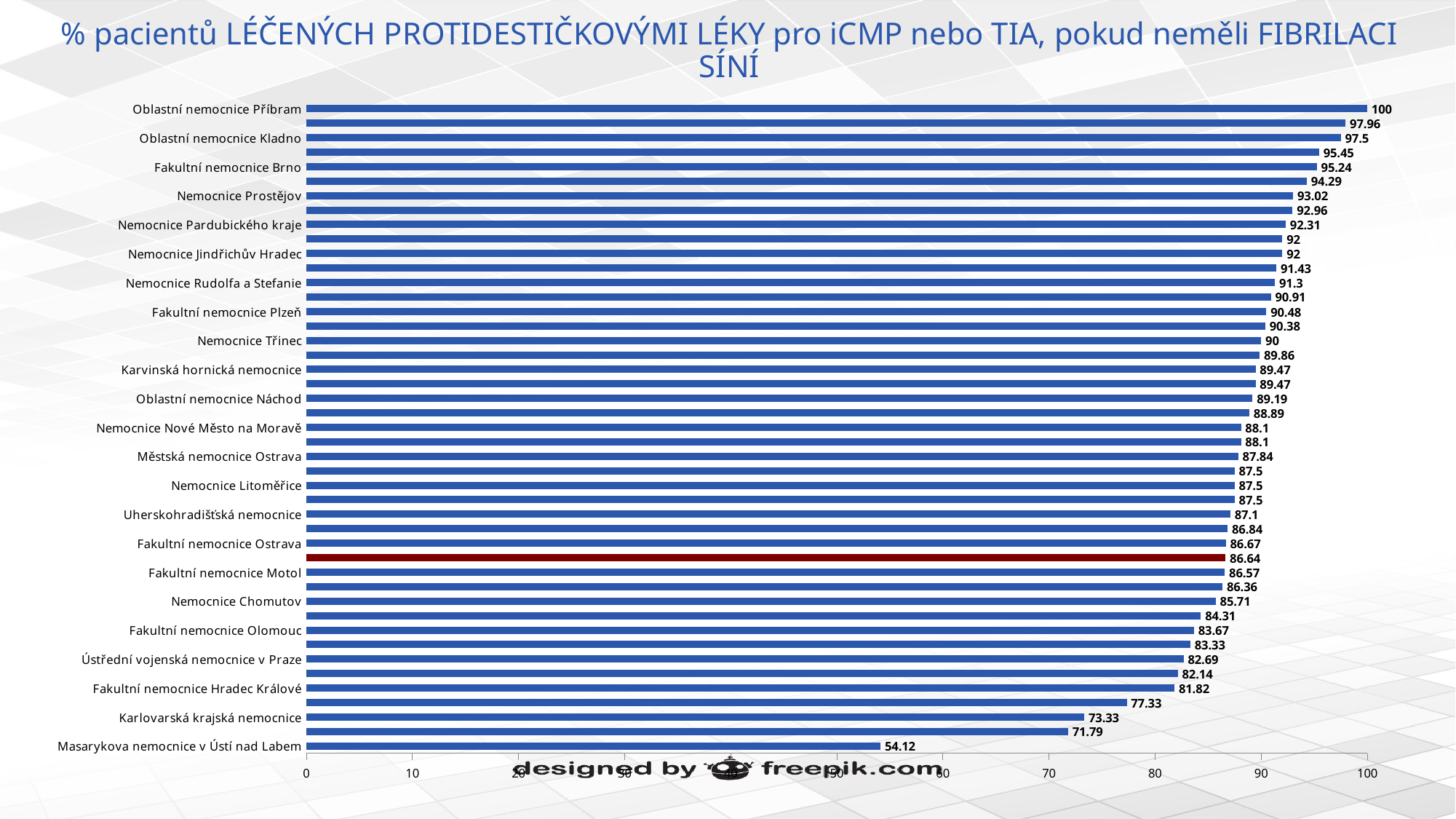
Which has a larger value, Fakultní nemocnice Brno or Fakultní nemocnice Olomouc? Fakultní nemocnice Brno What is the value for Fakultní nemocnice Motol? 86.57 What is the difference between the values for Oblastní nemocnice Příbram and Masarykova nemocnice v Ústí nad Labem? 45.88 What is the value of the bar highlighted in dark red? 86.64 Which hospital has the lowest value? Masarykova nemocnice v Ústí nad Labem How many bars are plotted in the chart? 45 What is the value for Masarykova nemocnice v Ústí nad Labem? 54.12 What is the value for Oblastní nemocnice Příbram? 100 What kind of chart is shown on the slide? bar chart Which hospital has the highest value? Oblastní nemocnice Příbram Is the value for Fakultní nemocnice Hradec Králové greater or less than 90? less What is the value for Karlovarská krajská nemocnice? 73.33